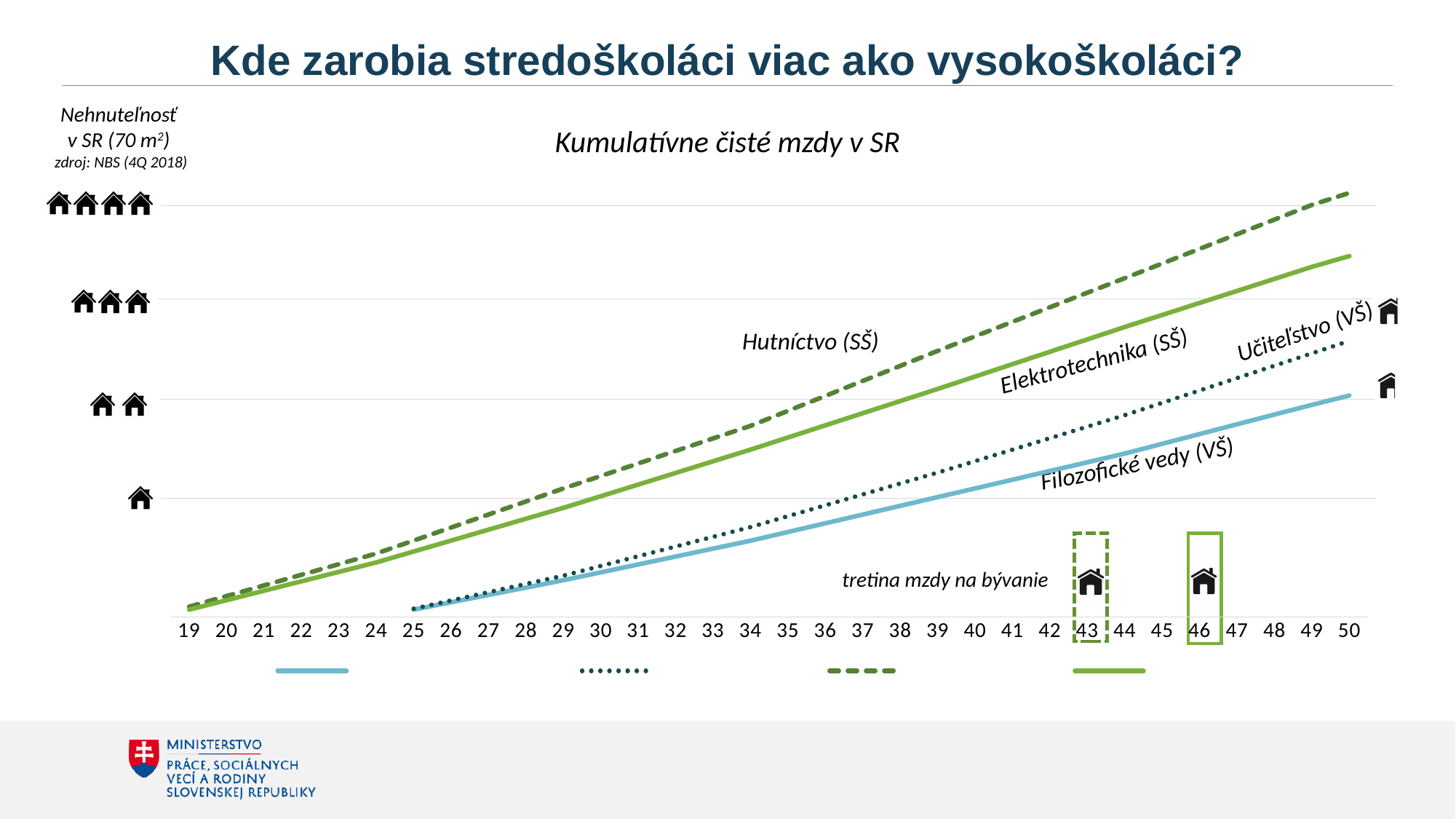
What kind of chart is shown on the slide? line chart Which series has the highest value at age 50? Hutníctvo (SŠ) At age 40, which is higher: Hutníctvo (SŠ) or Filozofické vedy (VŠ)? Hutníctvo (SŠ) Do the values of the Hutníctvo (SŠ) line rise or fall as age increases along the x axis? rise What is the last age shown on the x axis? 50 What is the title of the chart? Kumulatívne čisté mzdy v SR How many series (lines) are plotted on the chart? 4 How many age values are labelled on the x axis? 32 At what age do the Učiteľstvo (VŠ) and Filozofické vedy (VŠ) lines start? 25 What is the first age shown on the x axis? 19 Which series has the lowest value at age 50? Filozofické vedy (VŠ) At age 50, which is higher: Elektrotechnika (SŠ) or Učiteľstvo (VŠ)? Elektrotechnika (SŠ)